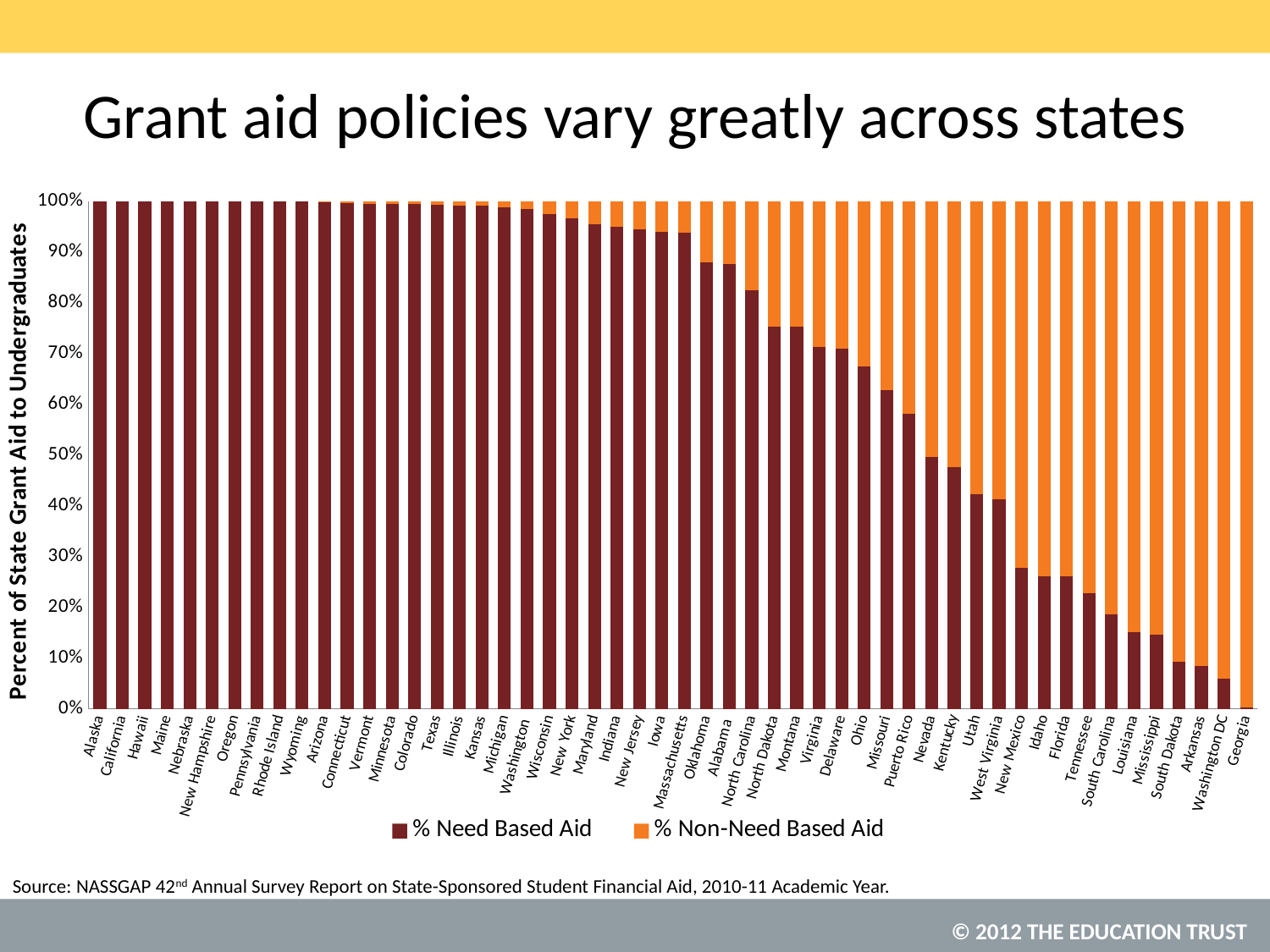
Is the % Need Based Aid value for Ohio greater or less than 60%? greater Is the % Need Based Aid value for Louisiana greater or less than 20%? less Which has a larger % Need Based Aid value, Ohio or Missouri? Ohio What is the label of the vertical axis? Percent of State Grant Aid to Undergraduates Is the % Need Based Aid value for Kentucky greater or less than 50%? less What is the % Need Based Aid value for Alaska? 100% What kind of chart is shown on the slide? stacked bar chart How many series does the legend list? 2 What is the total height of each stacked bar? 100% Does the % Need Based Aid value rise or fall moving from left to right along the x axis? fall What are the two series named in the legend? % Need Based Aid and % Non-Need Based Aid